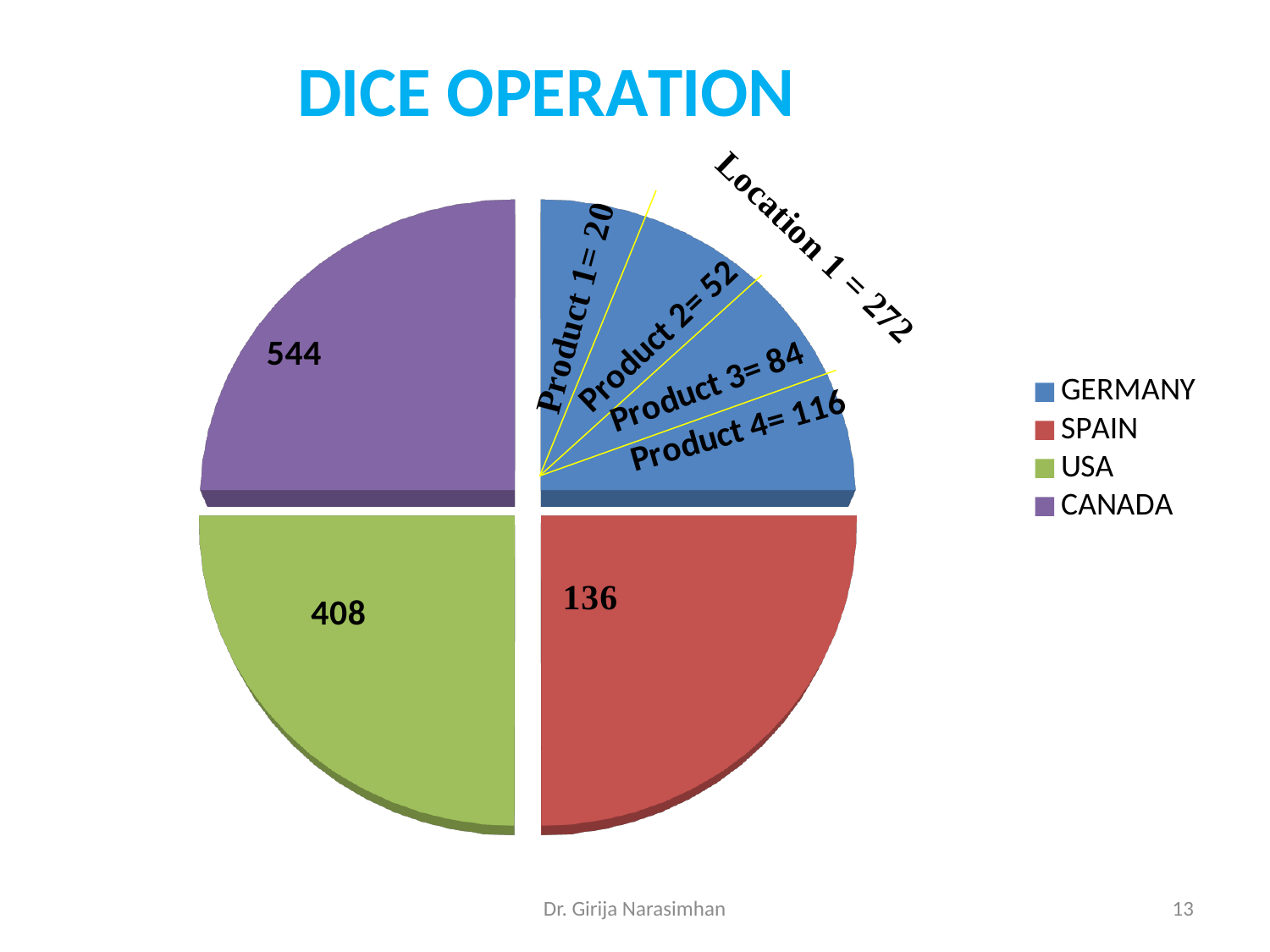
Which country has the lowest value in the pie chart? SPAIN What is the difference between the values for CANADA and USA? 136 Which is larger, the value for USA or the value for SPAIN? USA What is the value shown for CANADA? 544 Which country has the highest value in the pie chart? CANADA What kind of chart is shown on the slide? pie chart Which countries are listed in the legend? GERMANY, SPAIN, USA, CANADA How many slices does the pie chart have? 4 What is the value shown for SPAIN? 136 What is the difference between the values for USA and SPAIN? 272 What value is annotated for Product 4 within the blue slice? 116 What is the value shown for USA? 408